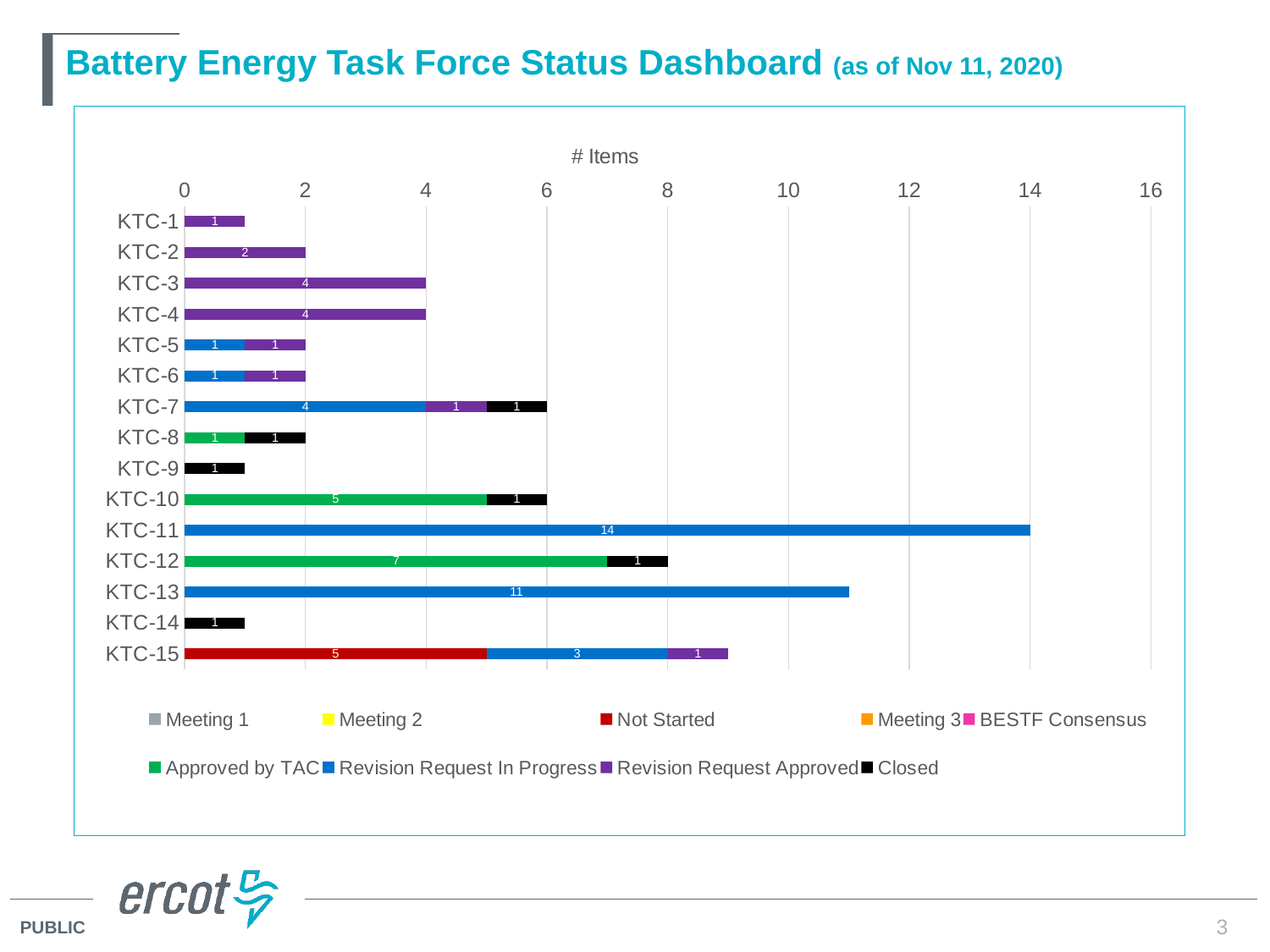
What is the Revision Request In Progress value for KTC-11? 14 How many series does the legend list? 9 What is the title shown on the value axis of the chart? # Items What kind of chart is shown on the slide? Stacked bar chart Which has a larger Approved by TAC value, KTC-10 or KTC-12? KTC-12 Which KTC has the longest bar overall? KTC-11 What is the total number of items for KTC-7? 6 What is the difference between the Revision Request In Progress values for KTC-11 and KTC-13? 3 What is the total number of items for KTC-15? 9 How many KTC categories are plotted on the chart? 15 What is the Not Started value for KTC-15? 5 What is the Approved by TAC value for KTC-12? 7